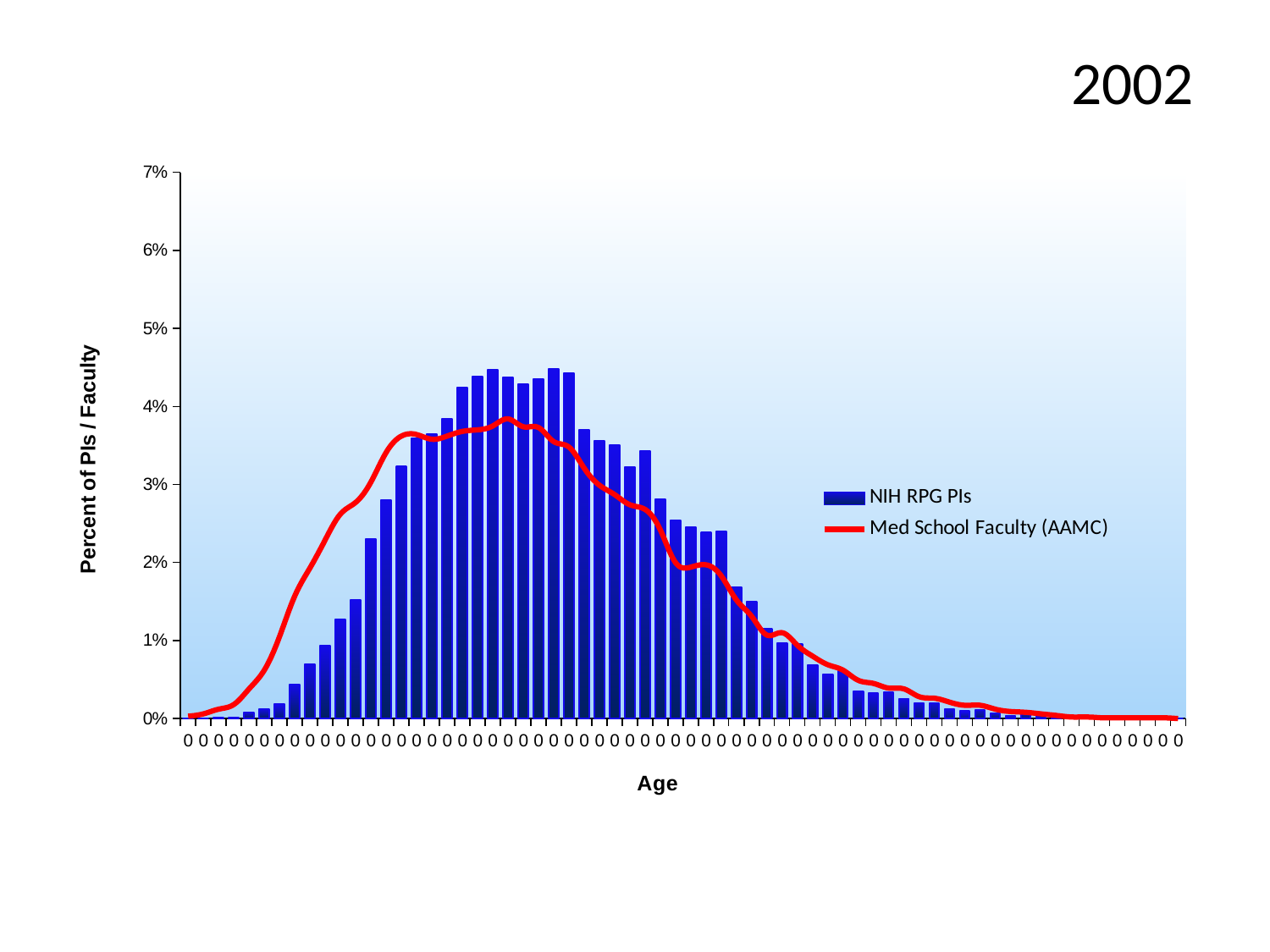
Is the peak value of the Med School Faculty (AAMC) line greater or less than 4%? less How many series does the legend list? 2 Is the peak value of the Med School Faculty (AAMC) line greater or less than 3%? greater Is the peak value of the NIH RPG PIs bars greater or less than 4%? greater What is the highest value shown on the y axis? 7% What kind of chart is shown on the slide? Bar chart with a line overlay Which series reaches a higher peak, NIH RPG PIs or Med School Faculty (AAMC)? NIH RPG PIs Over the left portion of the x axis, before the peak, do the Med School Faculty (AAMC) values rise or fall? rise Which series is drawn as blue bars? NIH RPG PIs Which series is drawn as a red line? Med School Faculty (AAMC) Over the right half of the x axis, do the NIH RPG PIs values rise or fall? fall